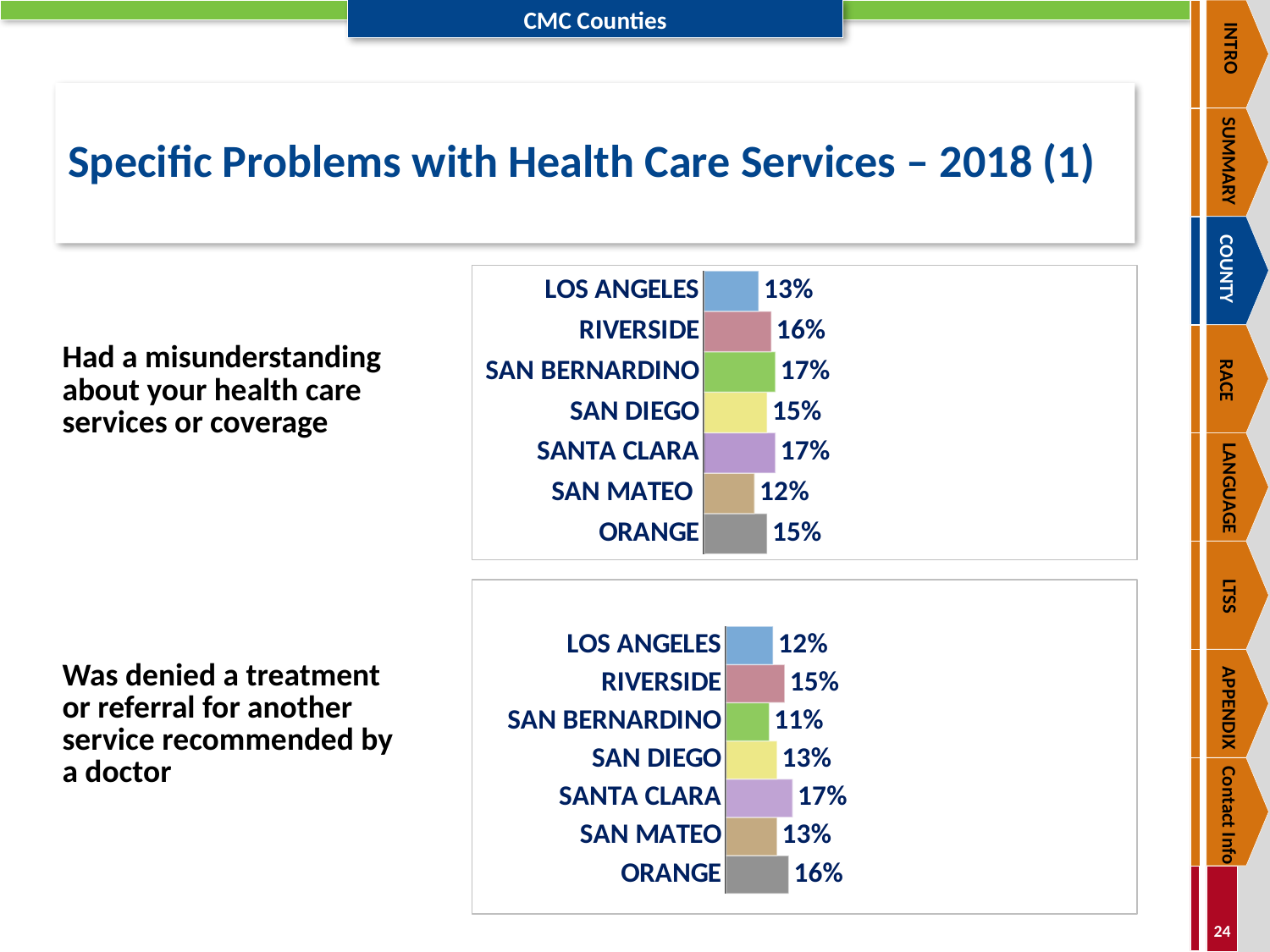
What kind of chart is the top chart (Had a misunderstanding about your health care services or coverage)? Bar chart In the bottom chart (Was denied a treatment or referral for another service recommended by a doctor), which county has the lowest value? SAN BERNARDINO In the bottom chart (Was denied a treatment or referral for another service recommended by a doctor), what is the value for SAN BERNARDINO? 11% In the top chart (Had a misunderstanding about your health care services or coverage), which is larger, SAN DIEGO or SAN MATEO? SAN DIEGO In the bottom chart (Was denied a treatment or referral for another service recommended by a doctor), what is the difference between ORANGE and LOS ANGELES? 4 percentage points What is the title of the slide? Specific Problems with Health Care Services – 2018 (1) In the top chart (Had a misunderstanding about your health care services or coverage), what is the value for RIVERSIDE? 16% In the bottom chart (Was denied a treatment or referral for another service recommended by a doctor), which county has the highest value? SANTA CLARA In the bottom chart (Was denied a treatment or referral for another service recommended by a doctor), which is larger, RIVERSIDE or SAN DIEGO? RIVERSIDE In the top chart (Had a misunderstanding about your health care services or coverage), how many counties are shown? 7 In the top chart (Had a misunderstanding about your health care services or coverage), what is the difference between SAN BERNARDINO and LOS ANGELES? 4 percentage points In the top chart (Had a misunderstanding about your health care services or coverage), which county has the lowest value? SAN MATEO